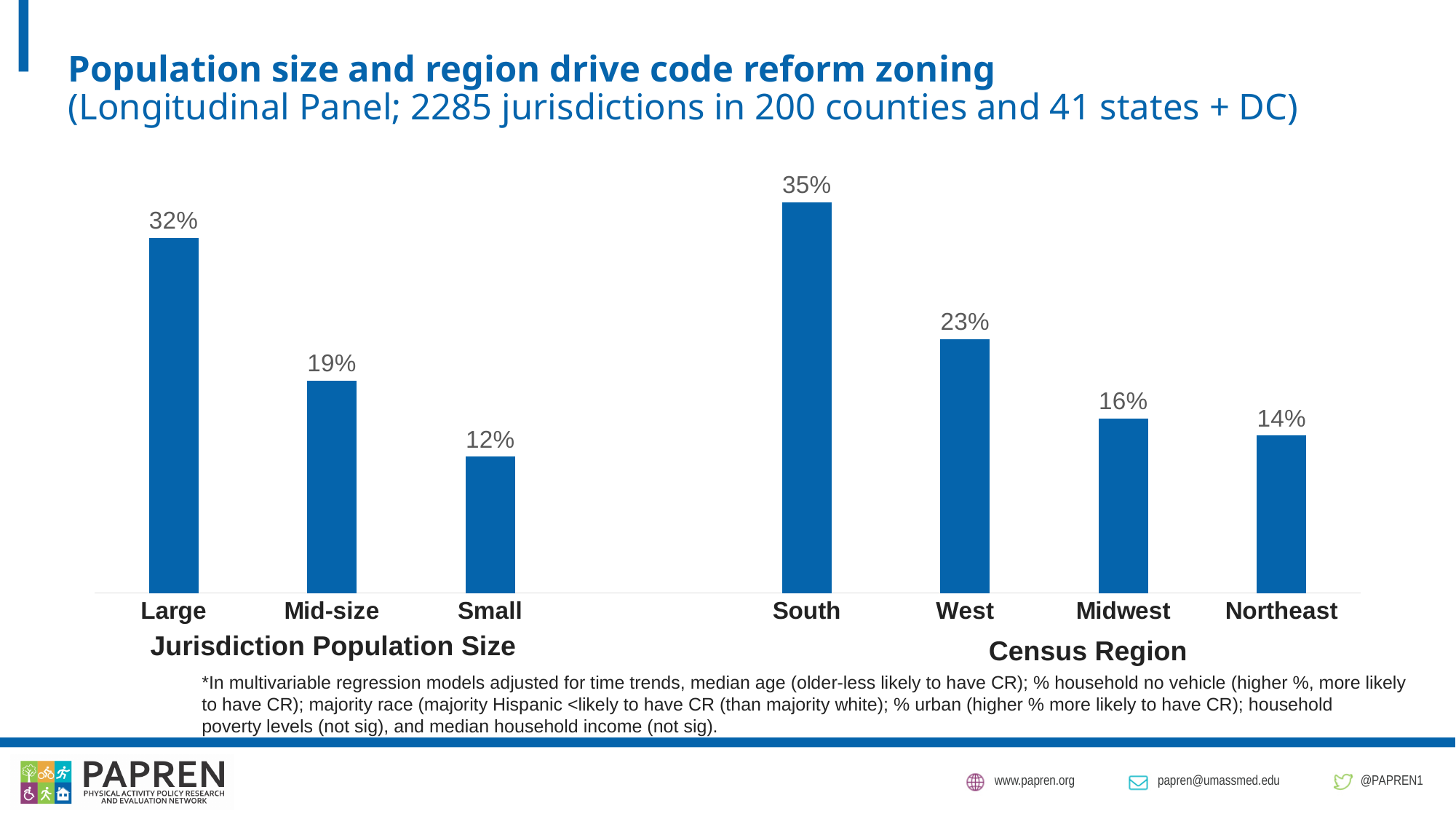
In the Census Region chart, what is the value for the West? 23% How many categories are shown in the Census Region chart? 4 In the Census Region chart, what is the difference between the values for South and Midwest? 19% In the Jurisdiction Population Size chart, what is the value for Large jurisdictions? 32% In the Jurisdiction Population Size chart, what is the value for Small jurisdictions? 12% In the Jurisdiction Population Size chart, do the values rise or fall from Large to Small? Fall In the Census Region chart, which region has the highest value? South In the Census Region chart, which is larger, the value for the Midwest or the Northeast? Midwest In the Jurisdiction Population Size chart, which category has the lowest value? Small What kind of chart is the Jurisdiction Population Size chart? Bar chart In the Census Region chart, what is the value for the Northeast? 14% In the Jurisdiction Population Size chart, what is the difference between the values for Large and Mid-size? 13%